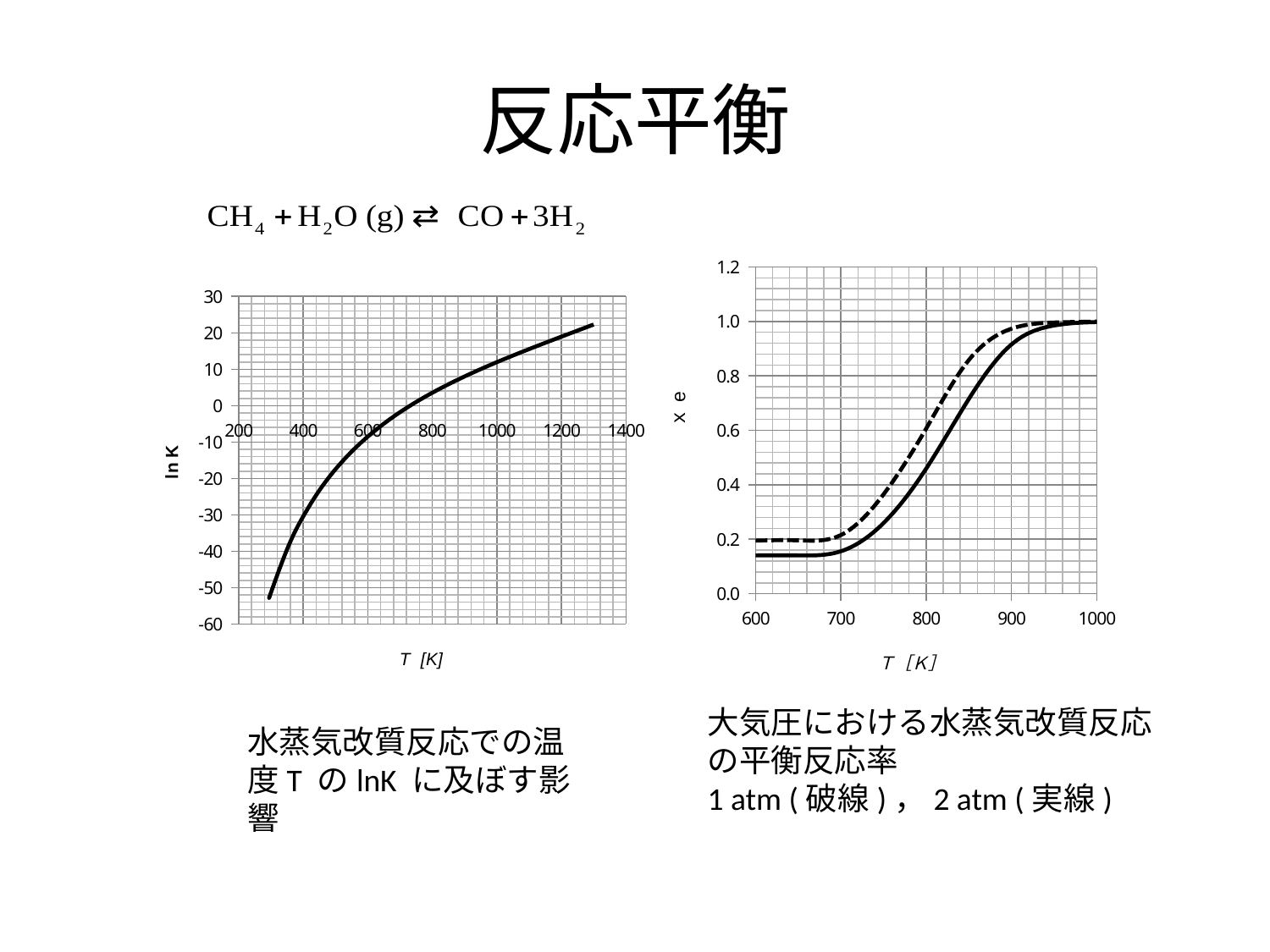
In the left chart, is the value of ln K at T = 800 K greater or less than 0? greater How many curves are plotted in the right chart? 2 In the left chart, is the value of ln K at T = 400 K greater or less than -10? less In the right chart, is the dashed-line value at T = 700 K greater or less than 0.4? less In the right chart, do the curves rise or fall as T increases from 600 to 1000 K? rise What kind of chart is the right chart (x e versus T)? line chart In the left chart, does ln K rise or fall as T increases? rise What kind of chart is the left chart (ln K versus T)? line chart What is the label of the x axis of the left chart? T [K] In the right chart, at T = 800 K, which curve has the higher value, the dashed line or the solid line? dashed line